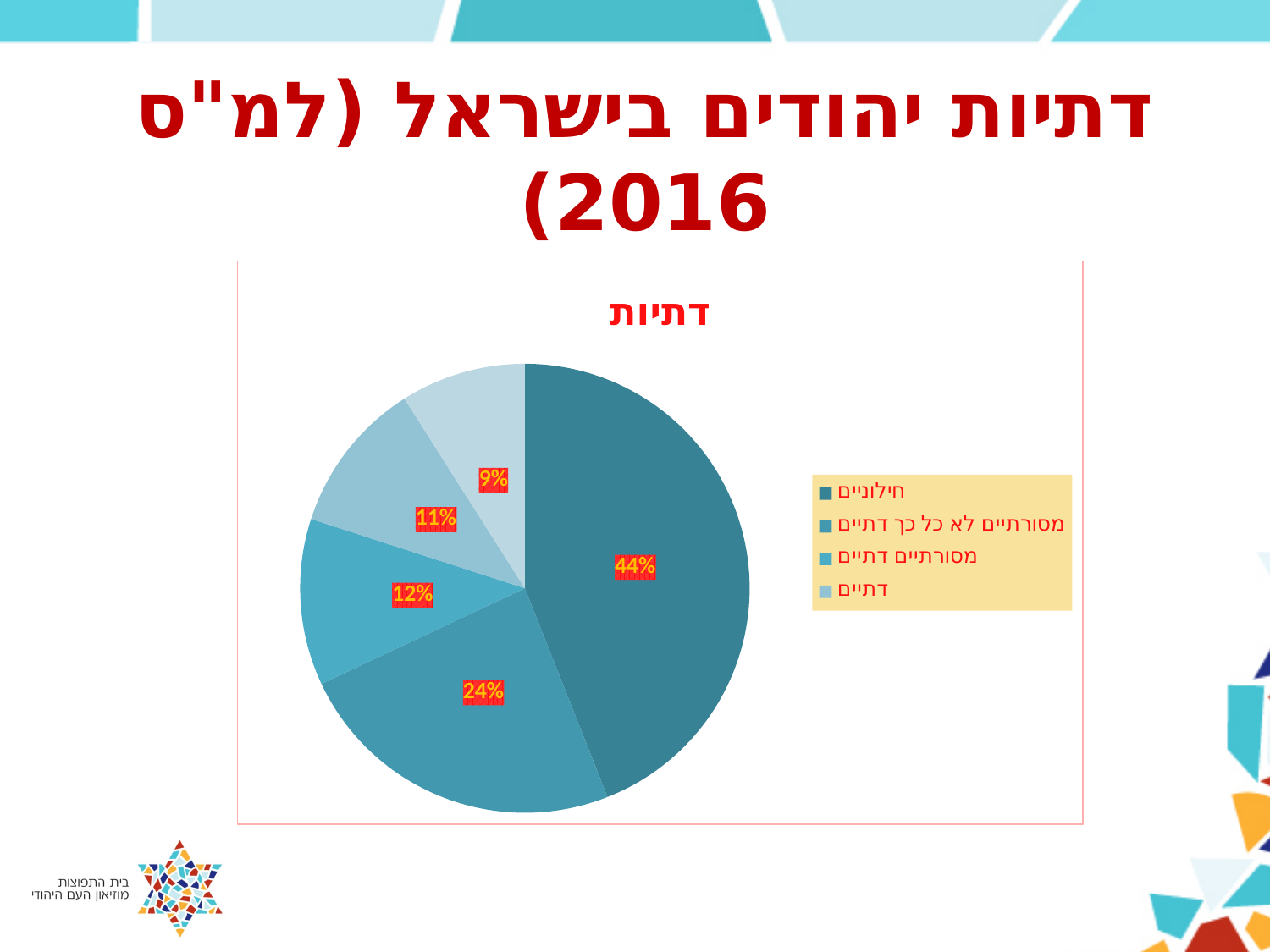
What kind of chart is shown on the slide? pie chart Which category has the largest slice of the pie? חילוניים What is the smallest percentage label shown on the pie? 9% How many entries does the chart legend list? 4 What is the difference in percentage points between the חילוניים slice and the מסורתיים לא כל כך דתיים slice? 20 What share of the pie is labelled for דתיים? 11% What share of the pie is labelled for מסורתיים לא כל כך דתיים? 24% What share of the pie is labelled for מסורתיים דתיים? 12% How many slices does the pie chart have? 5 What share of the pie is labelled for חילוניים? 44% What is the title of the chart? דתיות Which slice is larger, מסורתיים דתיים or דתיים? מסורתיים דתיים